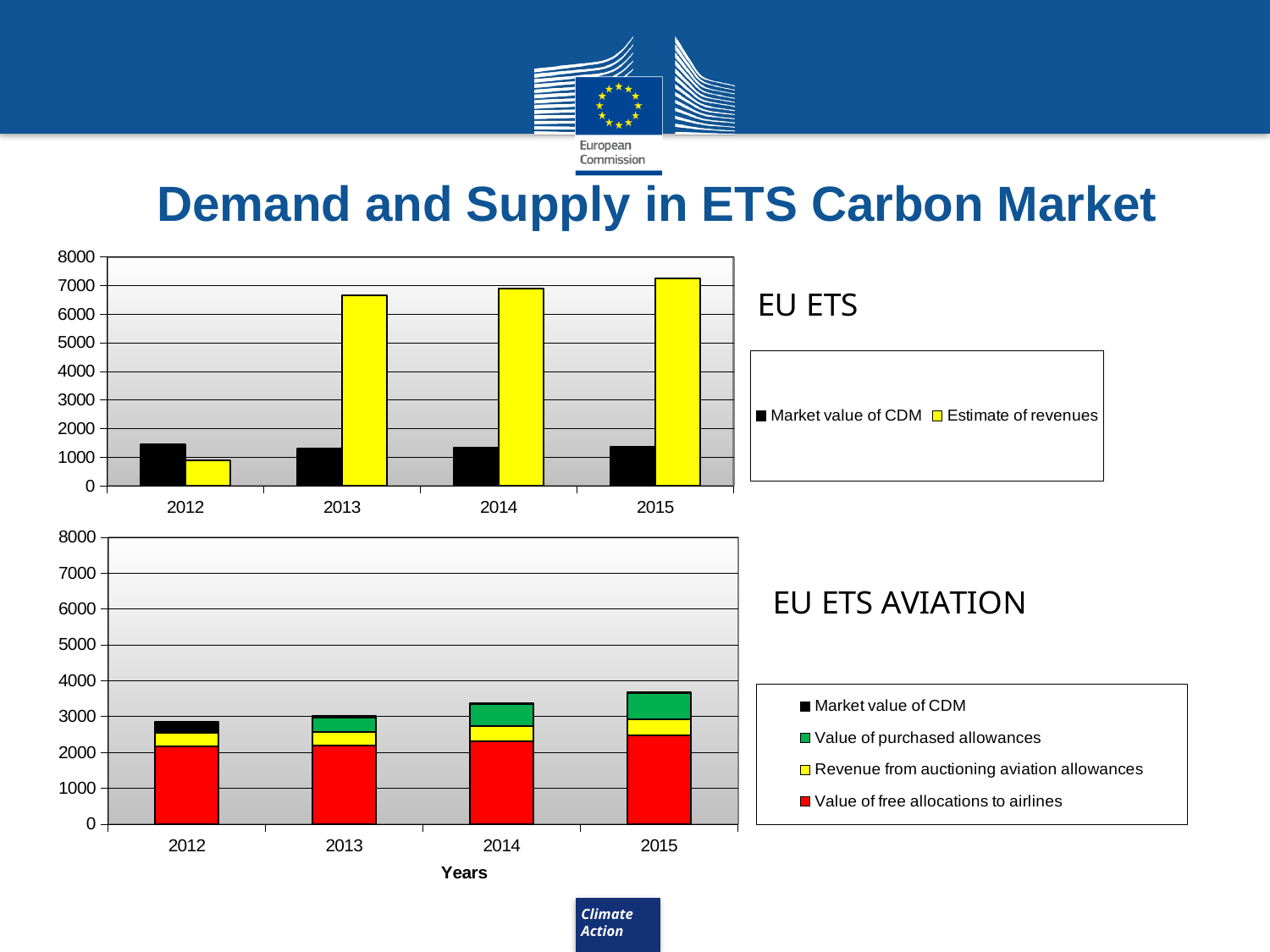
In the EU ETS AVIATION chart, is the Value of free allocations to airlines for 2015 greater or less than 2000? greater In the EU ETS chart, which year has the lowest Estimate of revenues? 2012 In the EU ETS chart for 2012, which is larger: Market value of CDM or Estimate of revenues? Market value of CDM How many series does the legend of the EU ETS chart list? 2 What is the x-axis title of the EU ETS AVIATION chart? Years How many years are shown on the x axis of the EU ETS AVIATION chart? 4 In the EU ETS AVIATION chart, does the total height of the stacked bars rise or fall from 2012 to 2015? rise What kind of chart is the EU ETS chart at the top of the slide? bar chart In the EU ETS chart, is the Estimate of revenues for 2013 greater or less than 6000? greater How many series does the legend of the EU ETS AVIATION chart list? 4 In the EU ETS chart, which year has the highest Estimate of revenues? 2015